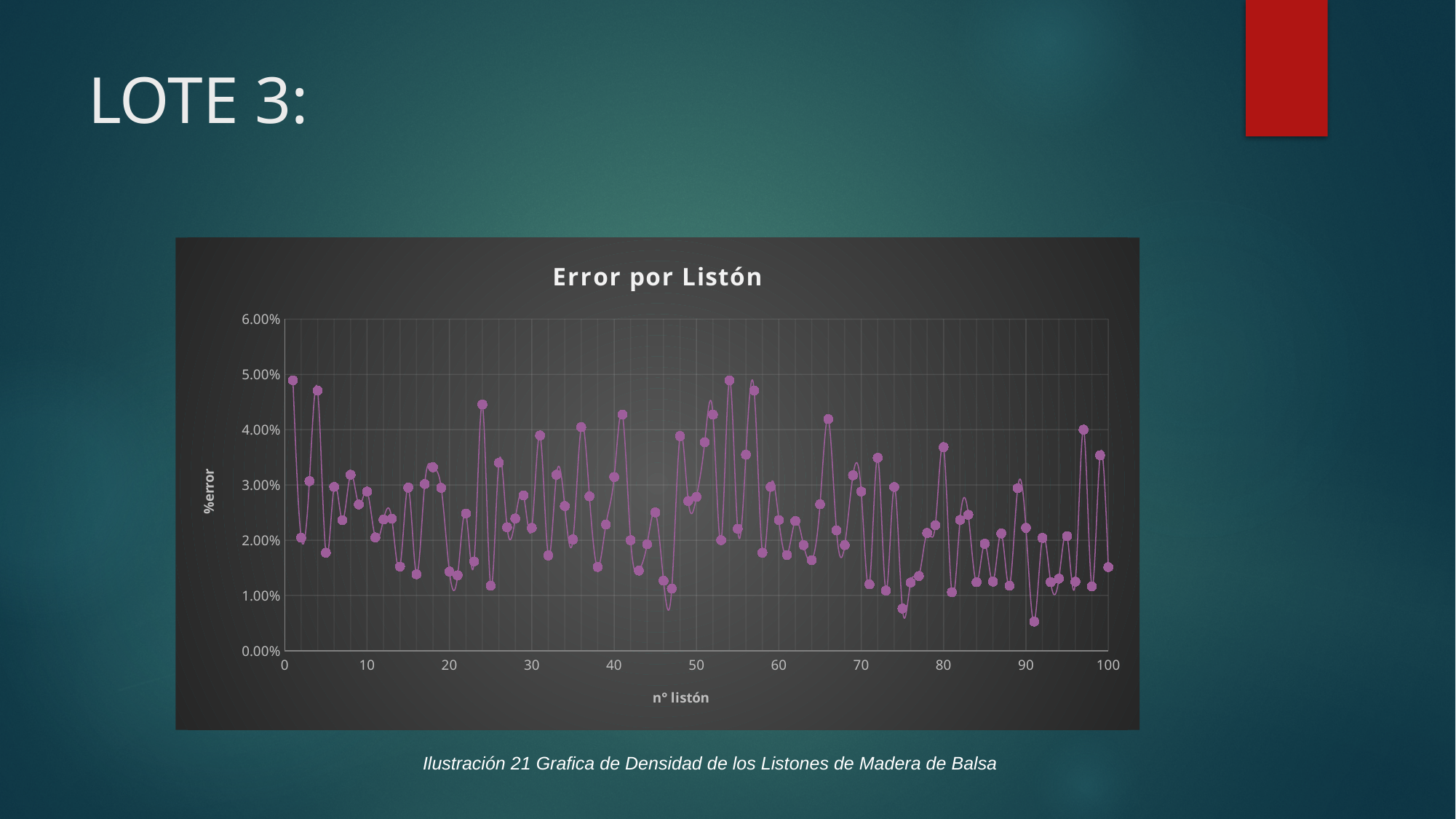
What kind of chart is shown on the slide? line chart What is the label of the x axis of the chart? nº listón Is the value for listón 24 greater or less than 4.00%? greater Which has the larger value, listón 1 or listón 2? listón 1 Is the value for listón 1 greater or less than 4.00%? greater Is the value for listón 97 greater or less than 3.00%? greater What is the title of the chart? Error por Listón Which has the larger value, listón 91 or listón 90? listón 90